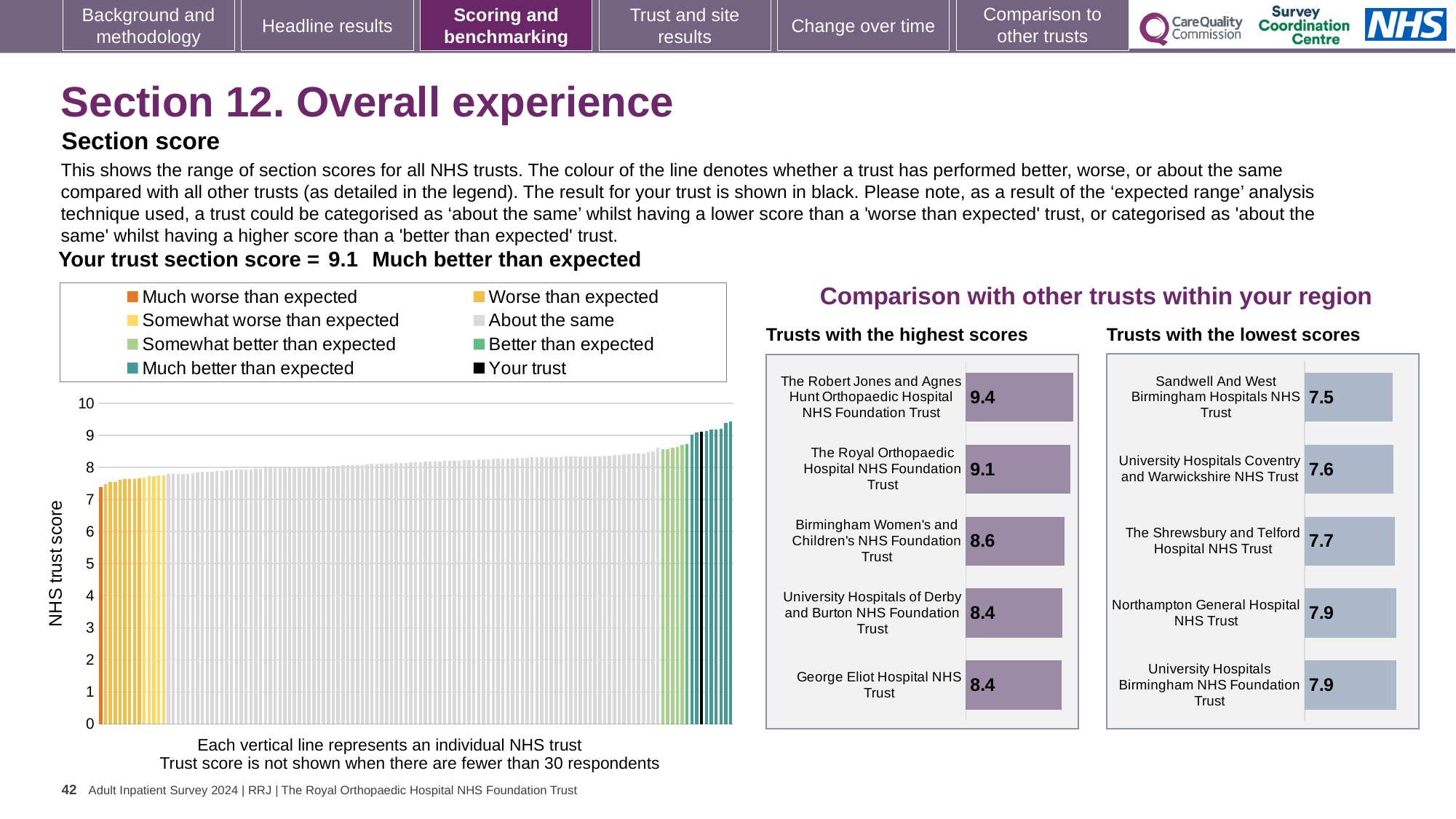
In the NHS trust score chart on the left, what is the section score for your trust (the black bar)? 9.1 In the 'Trusts with the lowest scores' chart, what is the score for The Shrewsbury and Telford Hospital NHS Trust? 7.7 In the NHS trust score chart on the left, do the bar values rise or fall from left to right? Rise In the 'Trusts with the highest scores' chart, what is the score for The Robert Jones and Agnes Hunt Orthopaedic Hospital NHS Foundation Trust? 9.4 In the 'Trusts with the highest scores' chart, what is the difference between the scores of The Robert Jones and Agnes Hunt Orthopaedic Hospital NHS Foundation Trust and Birmingham Women's and Children's NHS Foundation Trust? 0.8 In the 'Trusts with the highest scores' chart, which trust has the highest score? The Robert Jones and Agnes Hunt Orthopaedic Hospital NHS Foundation Trust In the 'Trusts with the lowest scores' chart, what is the score for Sandwell And West Birmingham Hospitals NHS Trust? 7.5 In the 'Trusts with the lowest scores' chart, which trust has the lowest score? Sandwell And West Birmingham Hospitals NHS Trust In the 'Trusts with the lowest scores' chart, which has the larger score: University Hospitals Coventry and Warwickshire NHS Trust or Northampton General Hospital NHS Trust? Northampton General Hospital NHS Trust How many categories does the legend of the NHS trust score chart on the left list? 8 What kind of chart is the NHS trust score chart on the left of the slide? Bar chart How many trusts are listed in the 'Trusts with the highest scores' chart? 5